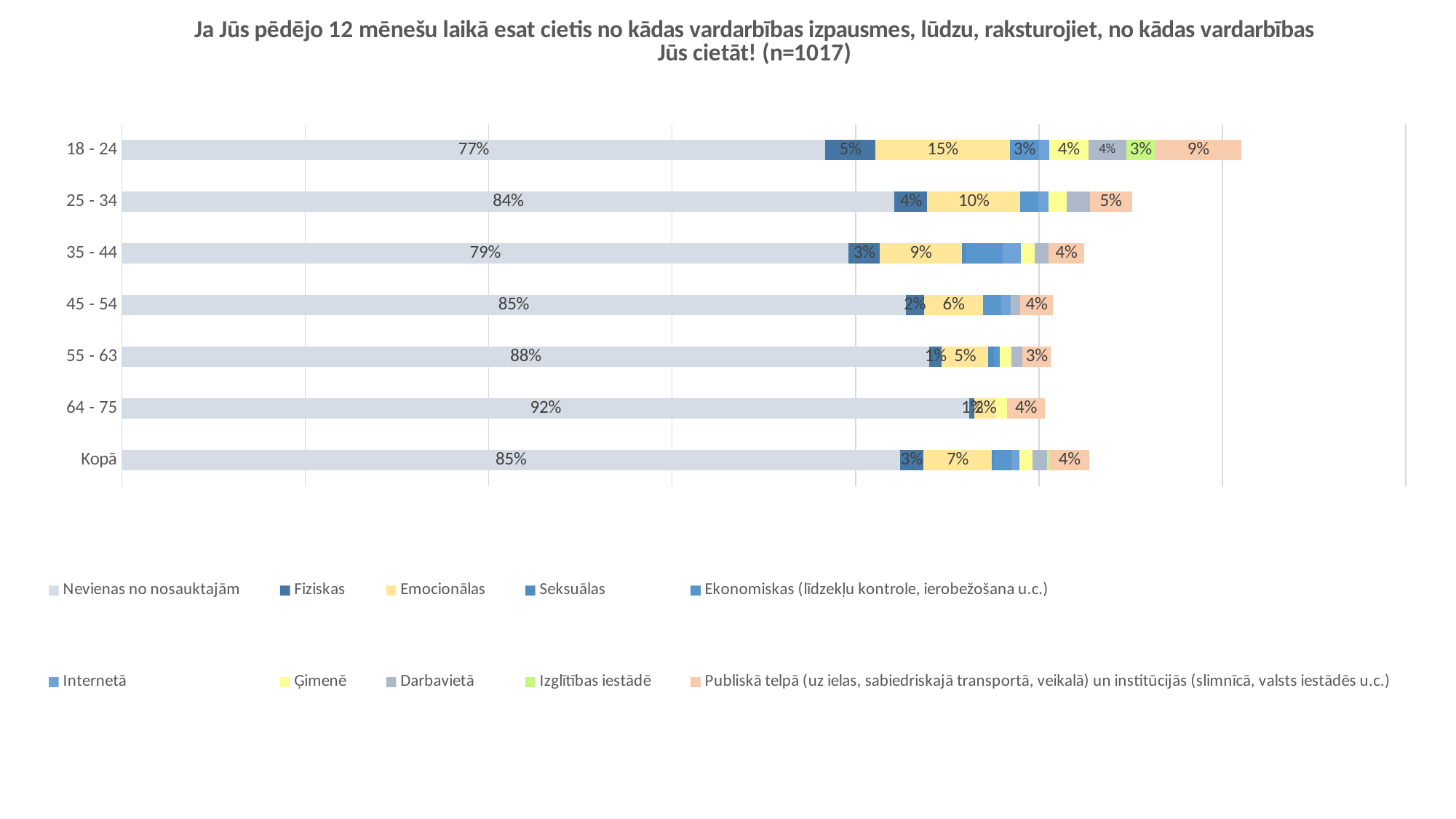
What is the value of 'Fiziskas' for the Kopā row? 3% What is the value of 'Emocionālas' for the 25 - 34 group? 10% Which age group has the lowest value for 'Nevienas no nosauktajām'? 18 - 24 Does the 'Nevienas no nosauktajām' value rise or fall as the age groups go from 18 - 24 to 64 - 75 (ignoring 35 - 44)? rise How many series does the legend list? 10 Which is larger: the 'Fiziskas' value for 18 - 24 or for 45 - 54? 18 - 24 What is the difference between the 'Emocionālas' values for 18 - 24 and Kopā? 8% How many age-group categories (including Kopā) are plotted on the chart? 7 What kind of chart is shown on the slide? stacked bar chart What is the value of 'Nevienas no nosauktajām' for the 18 - 24 group? 77% Which age group has the highest value for 'Nevienas no nosauktajām'? 64 - 75 What is the value of 'Publiskā telpā' for the 18 - 24 group? 9%